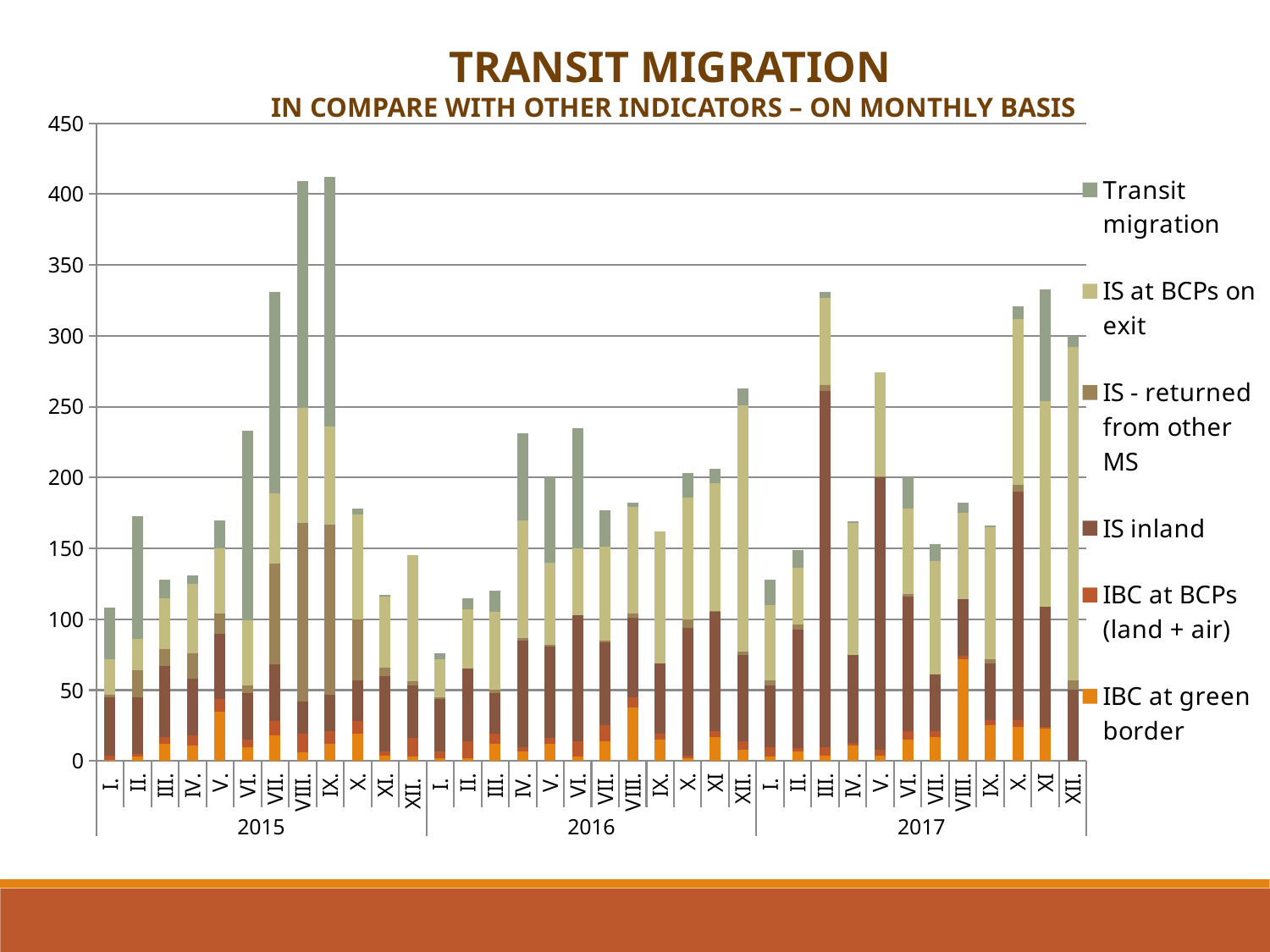
What kind of chart is shown on the slide? Stacked bar chart Which has the larger total bar, VI. 2015 or XII. 2016? XII. 2016 How many monthly bars are plotted in total across 2015, 2016 and 2017? 36 How many series does the legend list? 6 Is the total for XI. 2015 greater or less than 150? less Is the total for III. 2017 greater or less than 300? greater What is the main title of the chart? TRANSIT MIGRATION Which month has the lowest total bar on the chart? I. 2016 Do the total bars rise or fall from IX. 2015 to I. 2016? fall Is the total for I. 2016 greater or less than 100? less Which series is shown at the bottom of each stacked bar, in orange? IBC at green border